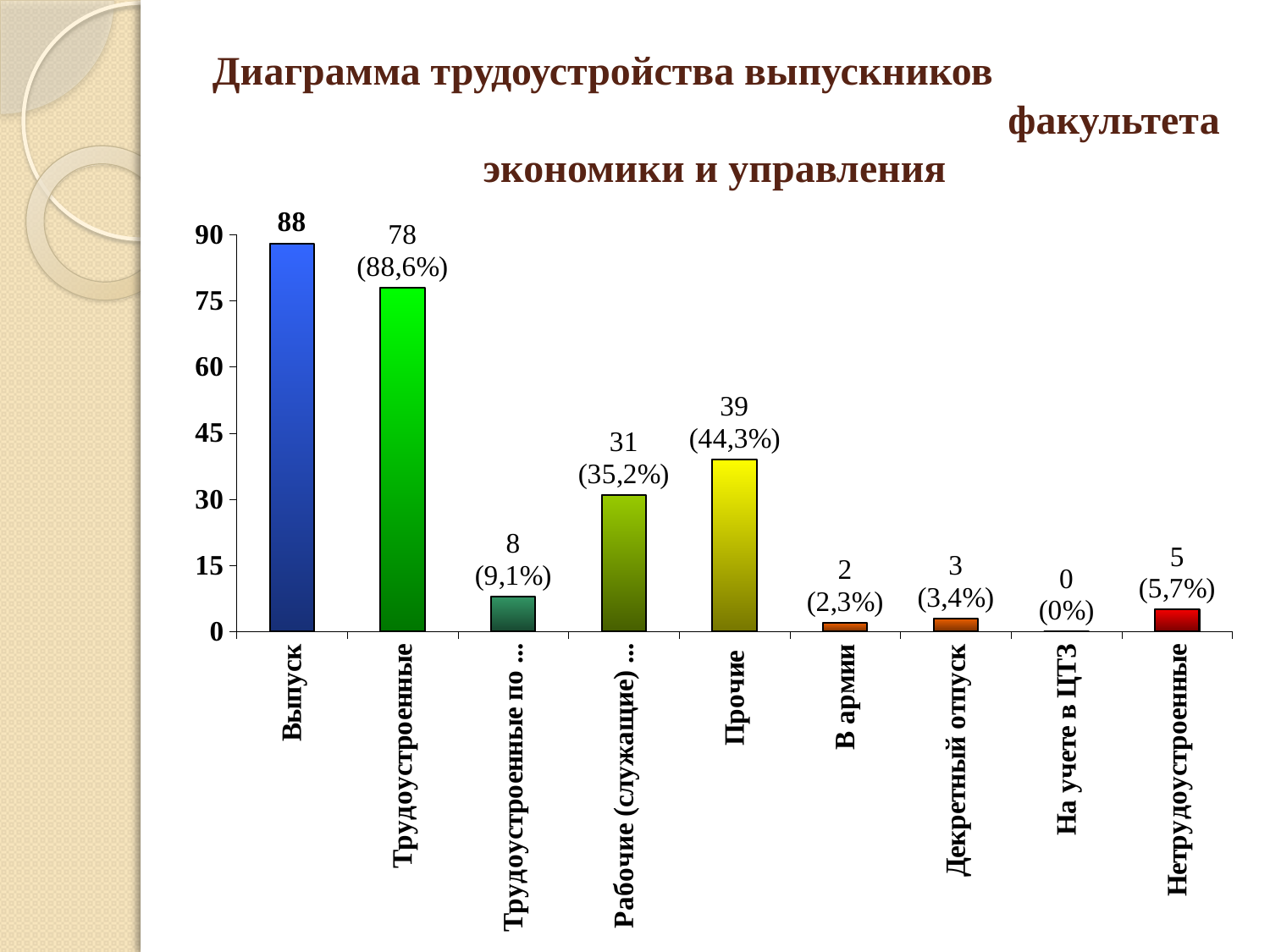
Which is larger, the value for В армии or the value for Декретный отпуск? Декретный отпуск What is the value for Выпуск? 88 Which category has the lowest value? На учете в ЦТЗ What is the difference between the values for Выпуск and Трудоустроенные? 10 What percentage is shown for Прочие? 44,3% How many categories (bars) are shown in the chart? 9 What type of chart is shown on the slide? bar chart What is the value for Трудоустроенные? 78 What is the title of the chart? Диаграмма трудоустройства выпускников факультета экономики и управления What is the value for Нетрудоустроенные? 5 Which category has the highest value? Выпуск What is the value for Декретный отпуск? 3